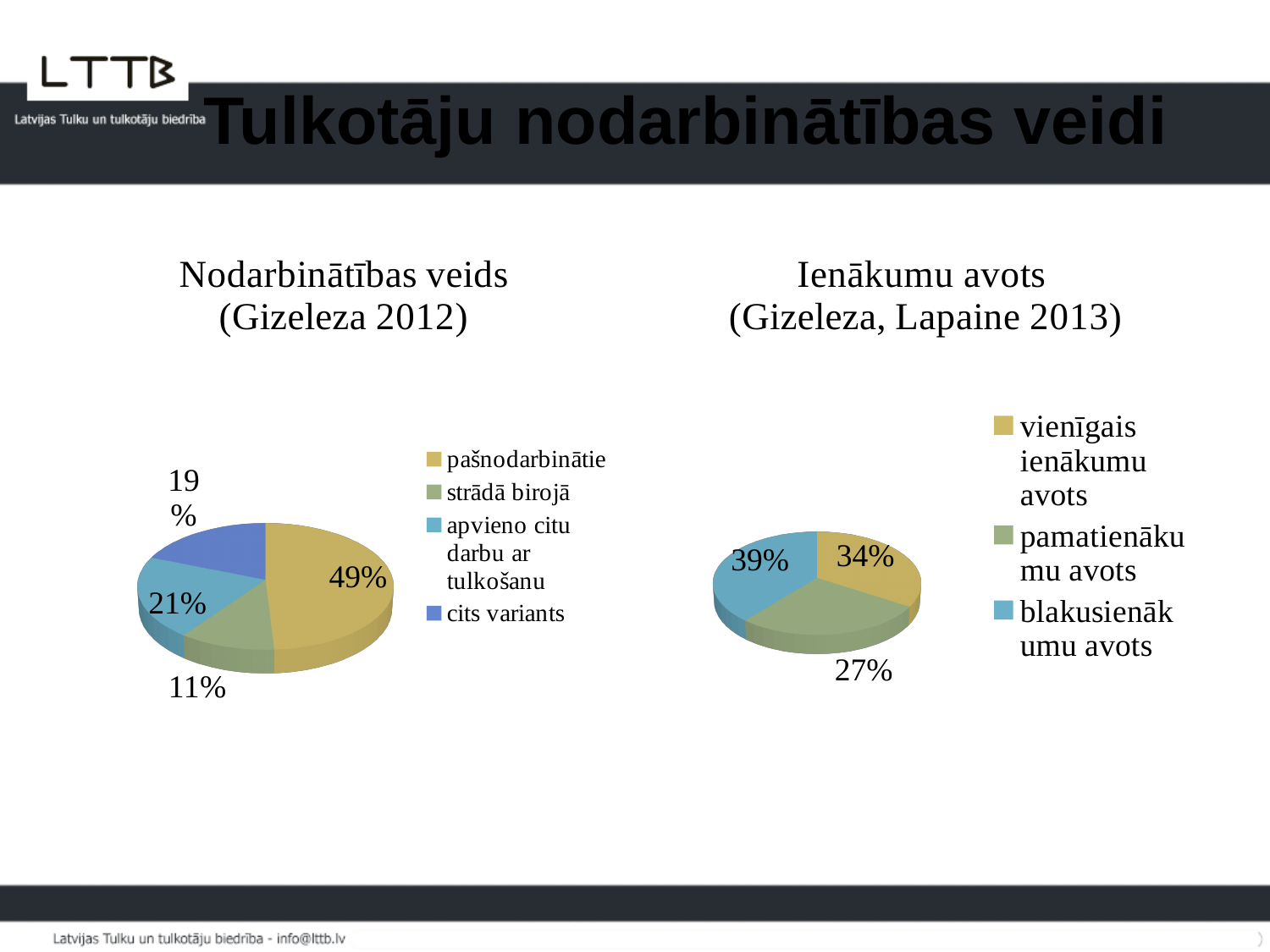
What kind of chart is the right chart (Ienākumu avots)? pie chart In the left chart (Nodarbinātības veids), what is the difference between the shares for pašnodarbinātie and cits variants? 30% In the right chart (Ienākumu avots), which category has the largest slice? blakusienākumu avots In the left chart (Nodarbinātības veids), what share is labelled for apvieno citu darbu ar tulkošanu? 21% In the right chart (Ienākumu avots), what share is labelled for blakusienākumu avots? 39% In the right chart (Ienākumu avots), what share is labelled for pamatienākumu avots? 27% In the left chart (Nodarbinātības veids), what share is labelled for strādā birojā? 11% In the right chart (Ienākumu avots), which is larger: vienīgais ienākumu avots or pamatienākumu avots? vienīgais ienākumu avots In the left chart (Nodarbinātības veids), which category has the largest slice? pašnodarbinātie In the left chart (Nodarbinātības veids), which category has the smallest slice? strādā birojā In the left chart (Nodarbinātības veids), what share is labelled for pašnodarbinātie? 49% In the left chart (Nodarbinātības veids), how many categories does the legend list? 4